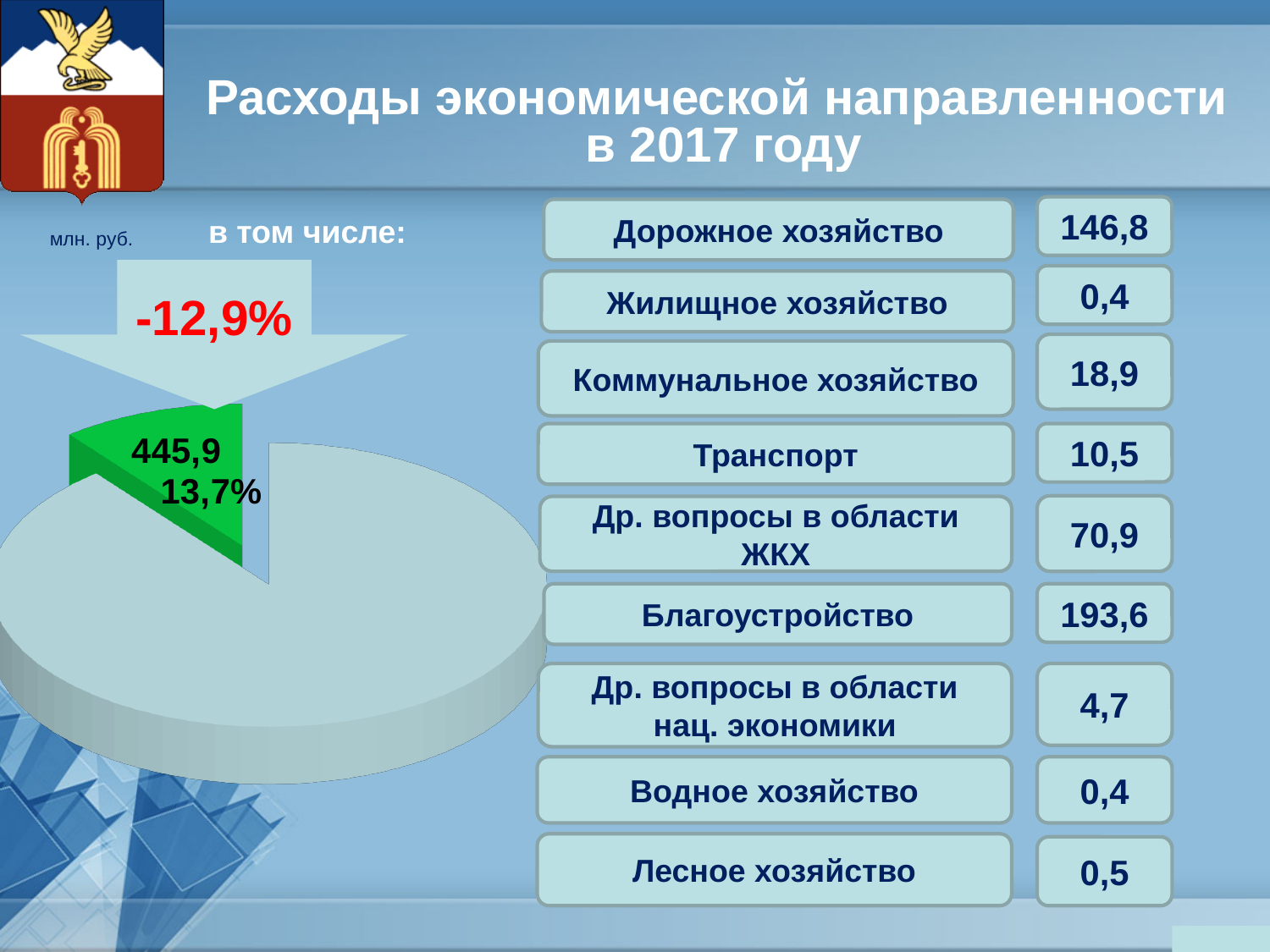
What value is printed on the green slice of the pie chart? 445,9 How many slices does the pie chart have? 2 In the breakdown on the right, what is the value for Благоустройство? 193,6 In the breakdown on the right, what is the value for Дорожное хозяйство? 146,8 What percentage change is shown in the arrow above the pie chart? -12,9% In the breakdown on the right, which item has the highest value? Благоустройство What kind of chart is shown on the left of the slide? pie chart What share of the pie does the green slice represent? 13,7% In the breakdown on the right, what is the difference between Благоустройство and Дорожное хозяйство? 46,8 How many items are listed in the breakdown on the right of the slide? 9 In the breakdown on the right, which is larger: Транспорт or Коммунальное хозяйство? Коммунальное хозяйство What unit is indicated for the values on the slide? млн. руб.